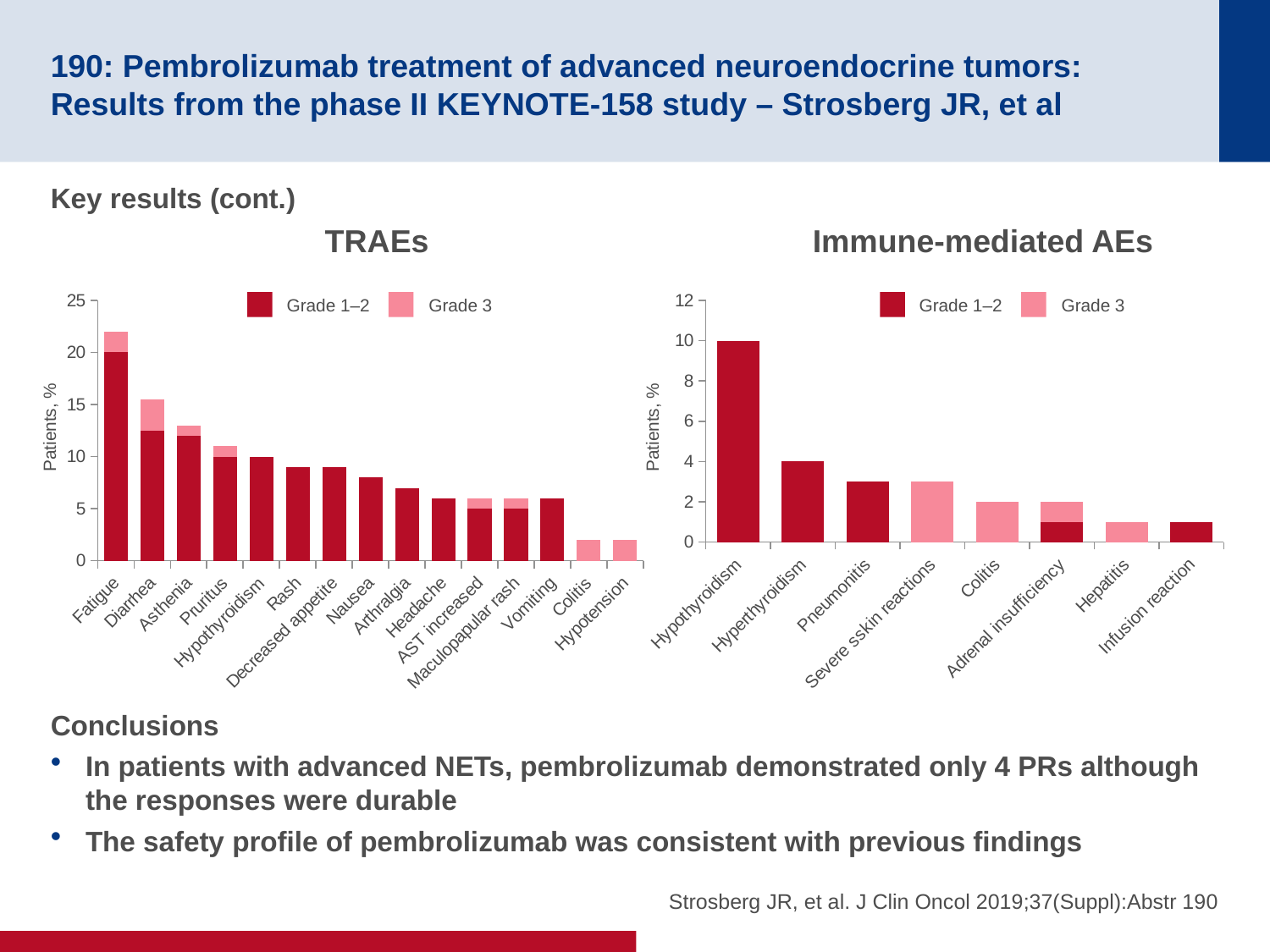
What type of chart is the TRAEs chart? Bar chart How many adverse event categories are shown in the TRAEs chart? 15 In the Immune-mediated AEs chart, which adverse event has the highest value? Hypothyroidism In the TRAEs chart, is the total value for Nausea greater or less than 10? less In the Immune-mediated AEs chart, which is larger, Hyperthyroidism or Pneumonitis? Hyperthyroidism In the TRAEs chart, which adverse event has the highest value? Fatigue In the Immune-mediated AEs chart, what is the difference between the values for Hypothyroidism and Hyperthyroidism? 6 How many series does the legend of the Immune-mediated AEs chart list? 2 In the TRAEs chart, what is the value for Hypothyroidism? 10 In the Immune-mediated AEs chart, what is the value for Hypothyroidism? 10 In the TRAEs chart, do the values rise or fall from left to right along the x axis? Fall In the Immune-mediated AEs chart, what is the value for Hyperthyroidism? 4